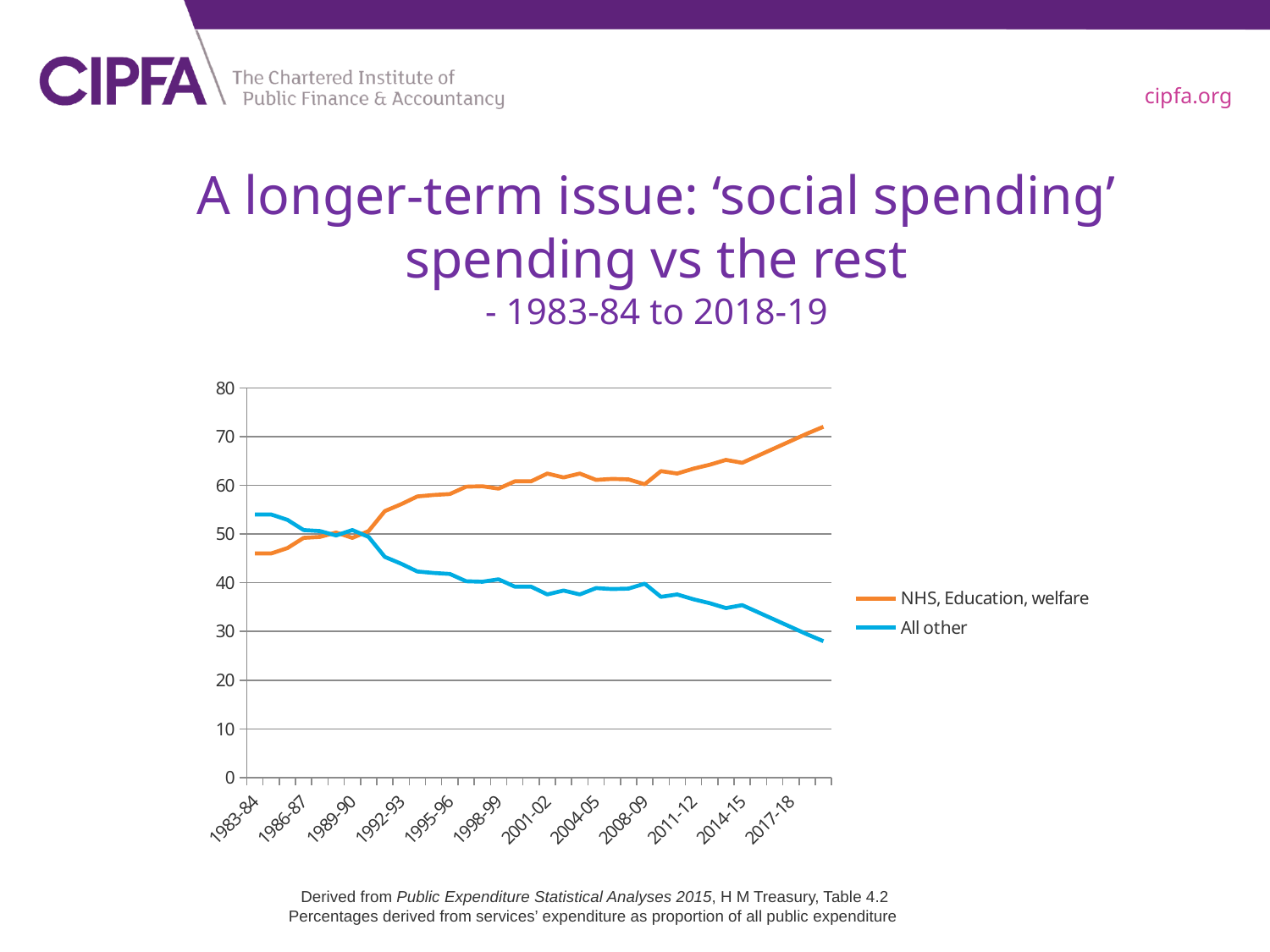
Does the 'All other' line rise or fall from 1983-84 to 2018-19? Fall Is the value for 'All other' in 2001-02 greater or less than 50? less Which series is drawn in orange? NHS, Education, welfare What kind of chart is shown on the slide? Line chart Is the value for 'All other' in 2017-18 greater or less than 40? less Does the 'NHS, Education, welfare' line rise or fall from 1983-84 to 2018-19? Rise Is the value for 'NHS, Education, welfare' in 1983-84 greater or less than 50? less What are the two series named in the legend? NHS, Education, welfare; All other How many series does the legend list? 2 In 2017-18, which series has the higher value, 'NHS, Education, welfare' or 'All other'? NHS, Education, welfare In 1983-84, which series has the higher value, 'NHS, Education, welfare' or 'All other'? All other